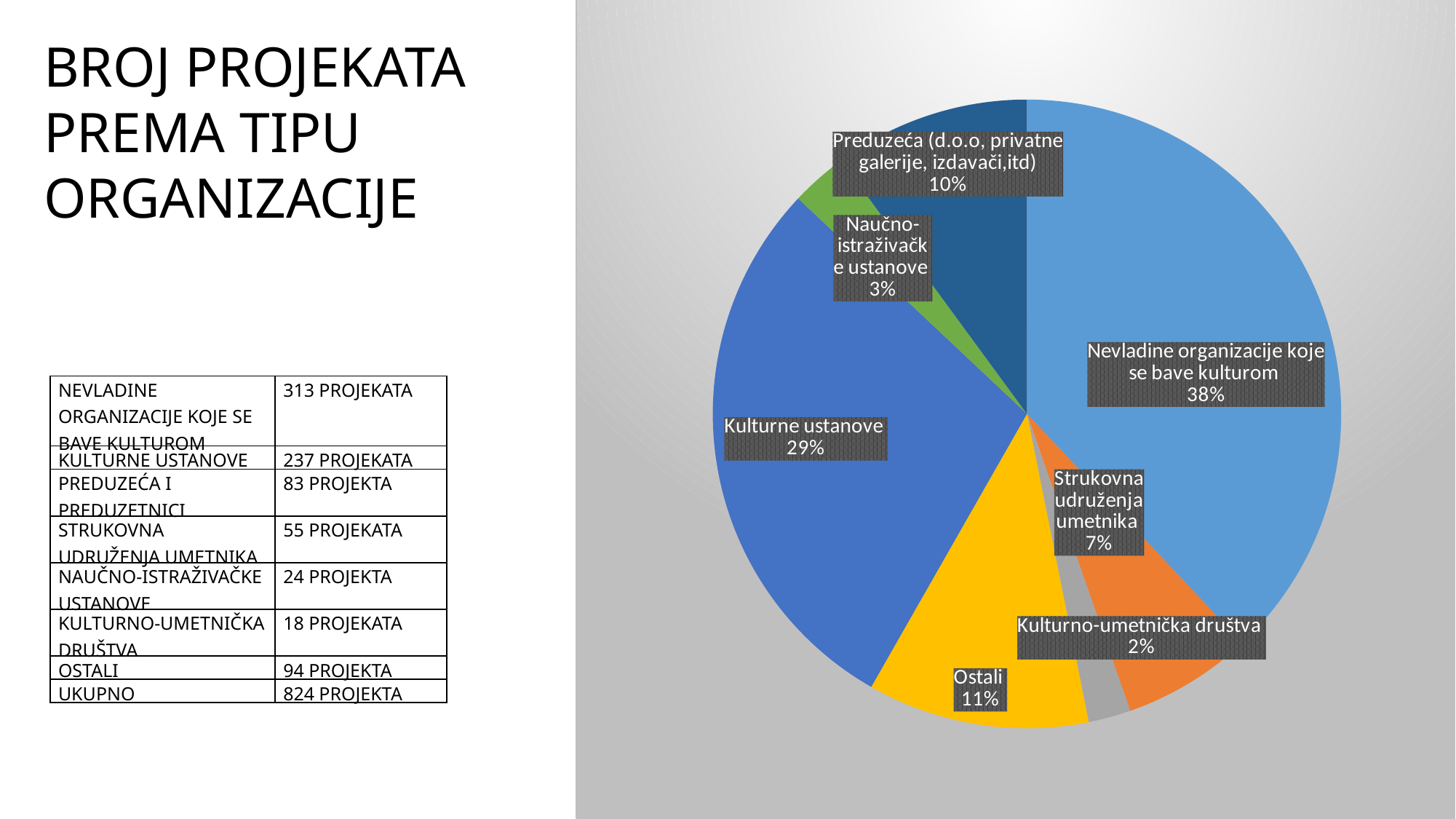
What share of the pie does "Kulturne ustanove" have? 29% What share of the pie does "Nevladine organizacije koje se bave kulturom" have? 38% What share of the pie does "Ostali" have? 11% Which slice of the pie chart is the largest? Nevladine organizacije koje se bave kulturom What is the difference in percentage points between "Nevladine organizacije koje se bave kulturom" and "Kulturne ustanove"? 9 How many slices does the pie chart have? 7 What is the title of the slide containing the pie chart? BROJ PROJEKATA PREMA TIPU ORGANIZACIJE What type of chart is shown on the slide? Pie chart Which slice of the pie chart is the smallest? Kulturno-umetnička društva Which is larger in the pie chart: "Ostali" or "Strukovna udruženja umetnika"? Ostali